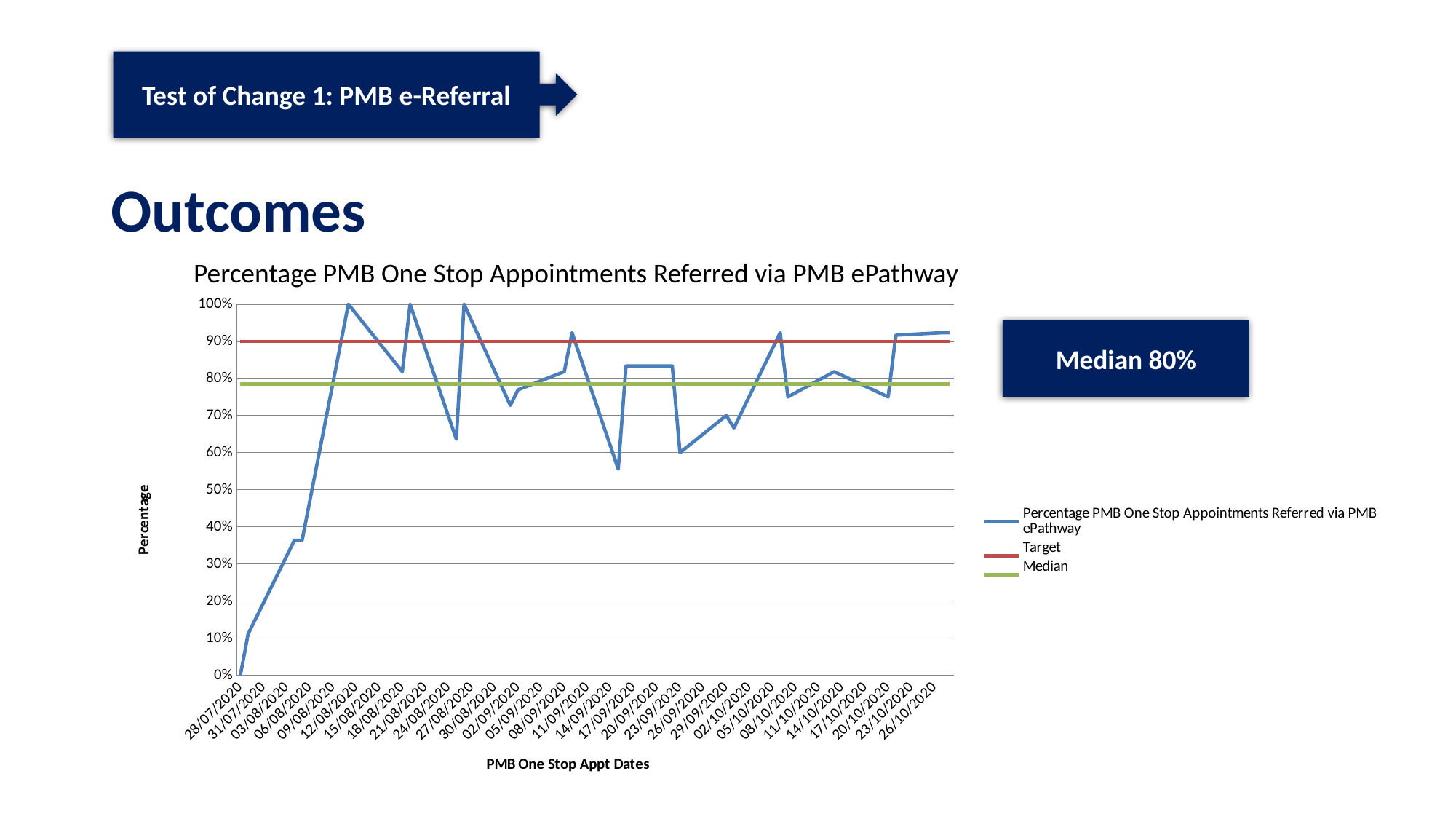
What is the title of the chart? Percentage PMB One Stop Appointments Referred via PMB ePathway Does the Percentage PMB One Stop Appointments Referred via PMB ePathway line rise or fall between 28/07/2020 and 12/08/2020? Rise What is the highest value reached by the Percentage PMB One Stop Appointments Referred via PMB ePathway line? 100% How many series does the chart legend list? 3 What is the label on the x axis of the chart? PMB One Stop Appt Dates What type of chart is shown on the slide? Line chart What is the value for 28/07/2020 on the Percentage PMB One Stop Appointments Referred via PMB ePathway line? 0% On which date is the Percentage PMB One Stop Appointments Referred via PMB ePathway line at its lowest? 28/07/2020